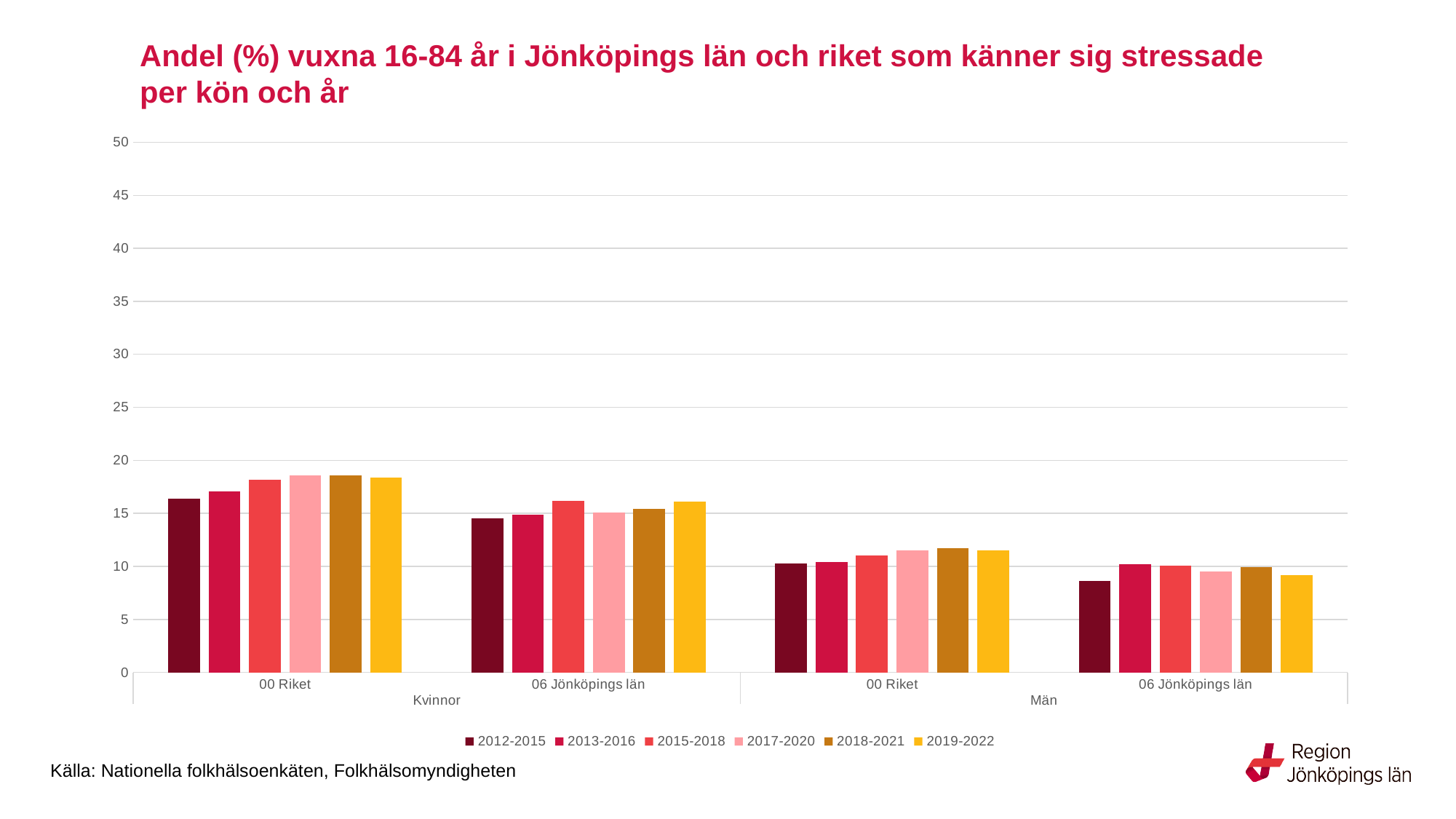
What kind of chart is shown on the slide? Bar chart For Män in 2012-2015, which is larger: the value for 00 Riket or the value for 06 Jönköpings län? 00 Riket How many category groups of bars are shown along the x axis? 4 Is the value for 2015-2018 for Kvinnor, 06 Jönköpings län greater or less than 15? greater For Kvinnor, 00 Riket, do the values rise or fall from 2012-2015 to 2017-2020? rise For 2012-2015 in 00 Riket, which is larger: the value for Kvinnor or the value for Män? Kvinnor Is the value for 2012-2015 for Män, 06 Jönköpings län greater or less than 10? less Is the value for 2018-2021 for Män, 00 Riket greater or less than 10? greater How many series does the legend list? 6 For 2019-2022 among Kvinnor, which is larger: the value for 00 Riket or the value for 06 Jönköpings län? 00 Riket Within the Män, 06 Jönköpings län group, which period has the lowest value? 2012-2015